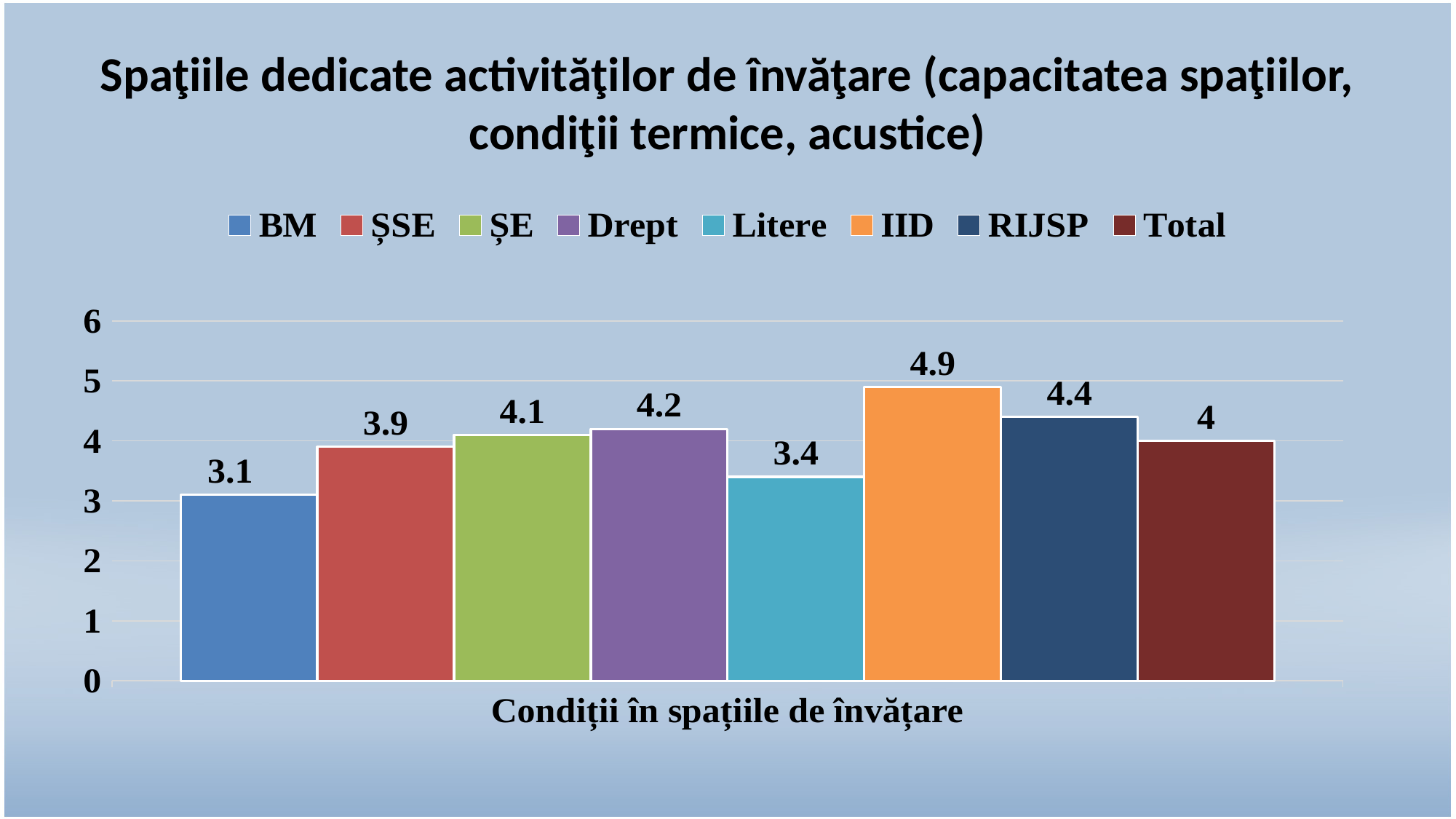
What is the value for Total? 4 Is the value for ȘSE greater or less than 4? less What is the difference between the values for IID and BM? 1.8 Which series has the highest value? IID What is the value for IID? 4.9 How many series does the legend list? 8 Which series has the lowest value? BM What is the value for BM? 3.1 What is the x-axis label of the chart? Condiții în spațiile de învățare What is the value for Litere? 3.4 What kind of chart is shown on the slide? bar chart Which is larger, the value for RIJSP or the value for Drept? RIJSP